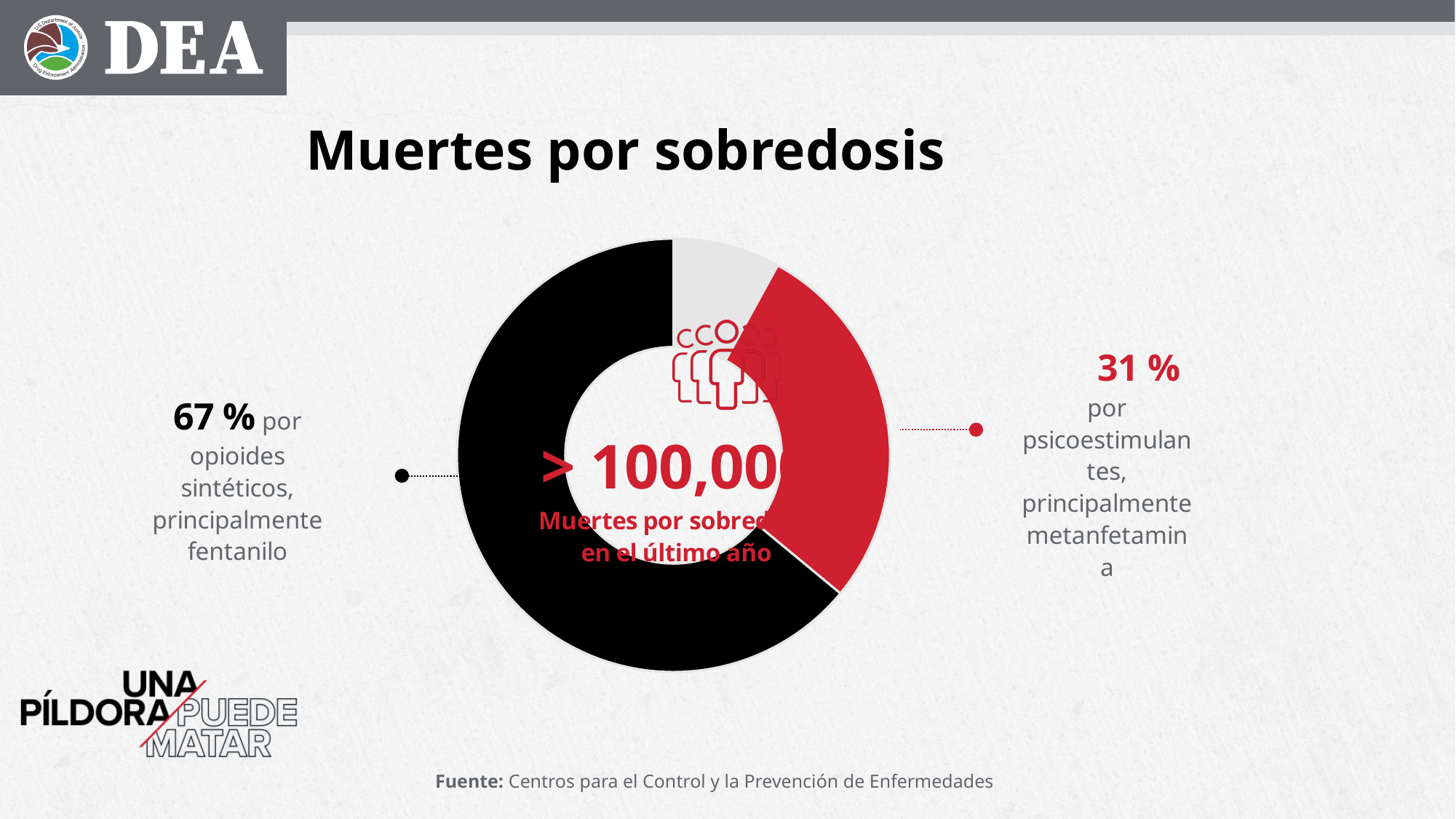
What is the difference in percentage points between the synthetic opioids share and the psychostimulants share? 36 % What is the title of the chart on the slide? Muertes por sobredosis What figure is shown in the centre of the chart for overdose deaths in the last year? > 100,000 What colour is the segment representing synthetic opioids? Black What kind of chart is shown on the slide? Pie (donut) chart Which labelled category accounts for the larger share of overdose deaths: synthetic opioids or psychostimulants? Synthetic opioids (opioides sintéticos) Is the share for synthetic opioids greater or less than 50 %? greater What percentage of overdose deaths is attributed to synthetic opioids, mainly fentanyl? 67 % Which labelled category has the largest segment in the chart? Opioides sintéticos, principalmente fentanilo What percentage of overdose deaths is attributed to psychostimulants, mainly methamphetamine? 31 % How many segments does the donut chart have? 3